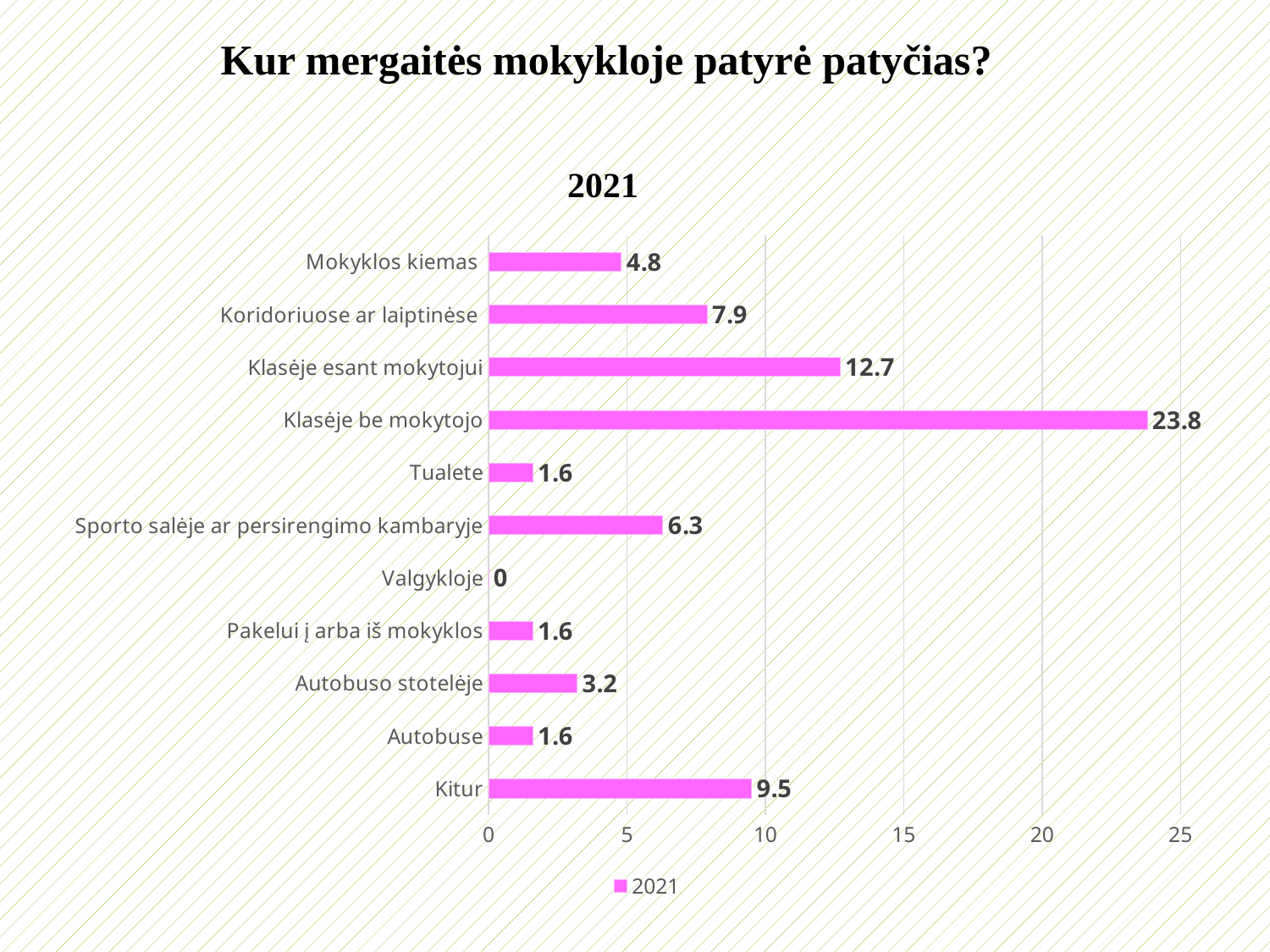
Which category has the lowest value? Valgykloje What is the value for Koridoriuose ar laiptinėse? 7.9 What is the difference between the values for Klasėje be mokytojo and Klasėje esant mokytojui? 11.1 Is the value for Klasėje esant mokytojui greater or less than 10? greater Which category has the highest value? Klasėje be mokytojo What is the value for Kitur? 9.5 Which is larger, the value for Mokyklos kiemas or the value for Sporto salėje ar persirengimo kambaryje? Sporto salėje ar persirengimo kambaryje How many series does the legend list? 1 What is the value for Klasėje be mokytojo? 23.8 What is the title of the chart? 2021 What kind of chart is shown on the slide? bar chart How many categories are shown in the chart? 11